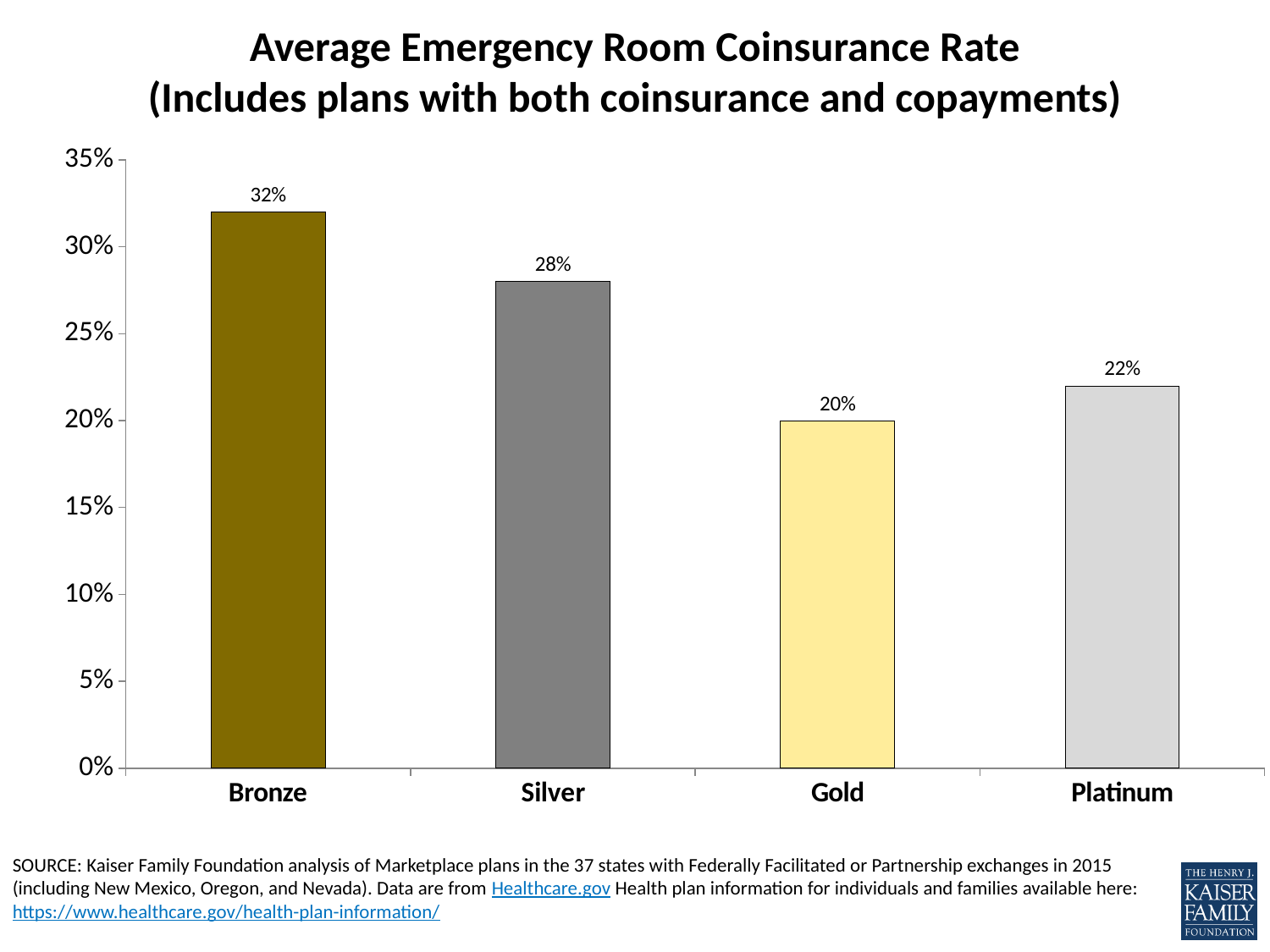
What is the difference between the Bronze and Silver average emergency room coinsurance rates? 4 percentage points What is the average emergency room coinsurance rate for Platinum plans? 22% Which plan type has the lowest average emergency room coinsurance rate? Gold Which plan type has the highest average emergency room coinsurance rate? Bronze What kind of chart is shown on the slide? Bar chart What is the title of the chart? Average Emergency Room Coinsurance Rate (Includes plans with both coinsurance and copayments) Which has a higher average emergency room coinsurance rate, Silver or Platinum? Silver How many plan types are shown in the chart? 4 What is the average emergency room coinsurance rate for Silver plans? 28% What is the average emergency room coinsurance rate for Bronze plans? 32% What is the average emergency room coinsurance rate for Gold plans? 20% What is the difference between the Platinum and Gold average emergency room coinsurance rates? 2 percentage points